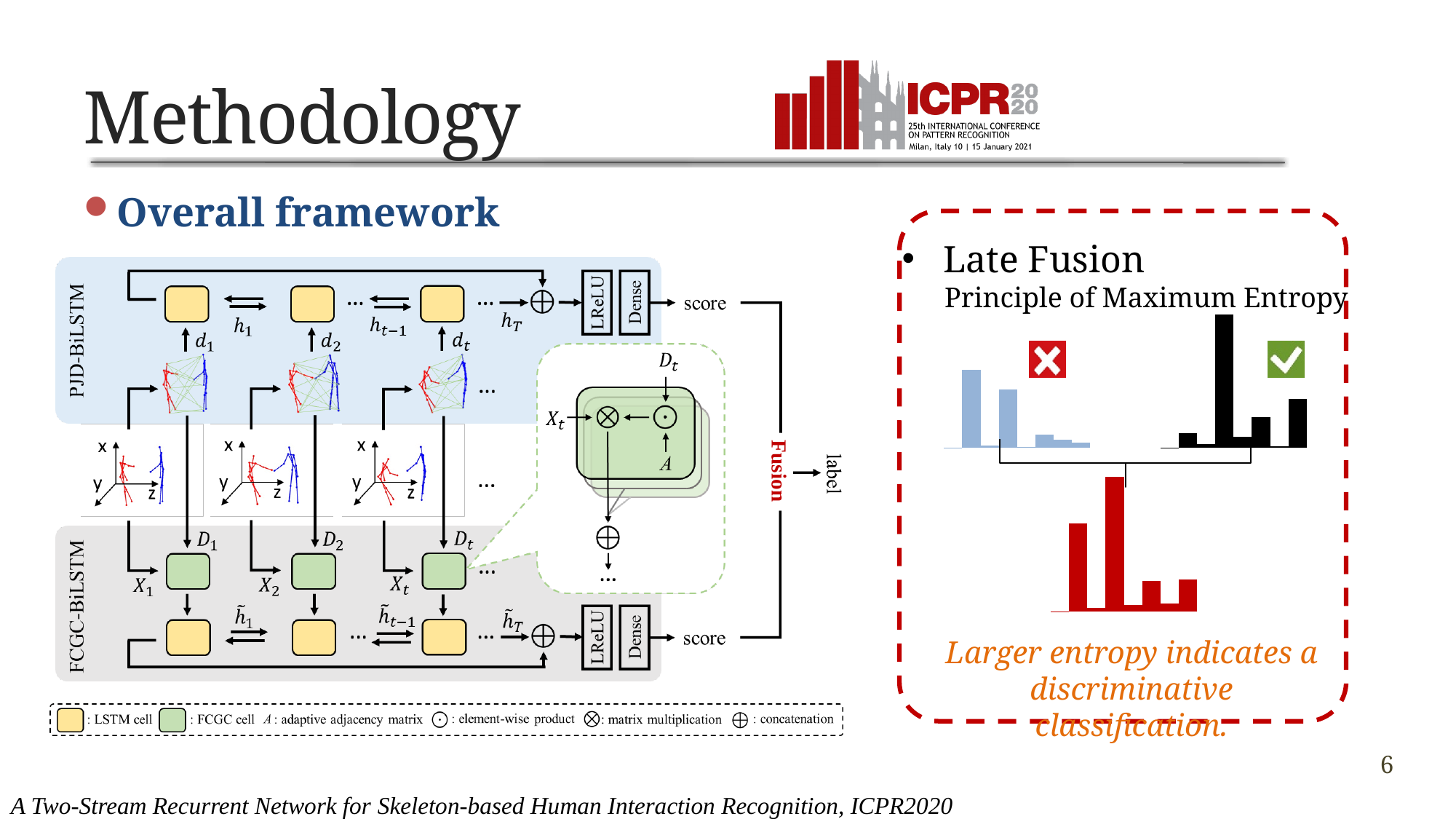
In the red bar chart, is the first bar taller or shorter than the second bar? shorter In the red bar chart (bottom of the Late Fusion box), which bar is the tallest, counting from the left? the second Which of the two top bar charts in the Late Fusion box is marked with a green check mark, the blue one or the black one? the black one In the blue bar chart, do the bar heights rise or fall from left to right? fall What kind of charts are the three small charts inside the dashed 'Late Fusion' box? bar charts What colour are the bars in the bottom bar chart of the Late Fusion box? red In the blue bar chart (top left of the Late Fusion box), which bar is the tallest, counting from the left? the first In the black bar chart (top right of the Late Fusion box), which bar is the tallest, counting from the left? the second In the black bar chart, is the leftmost bar taller or shorter than the rightmost bar? shorter How many small bar charts are shown inside the dashed 'Late Fusion' box? 3